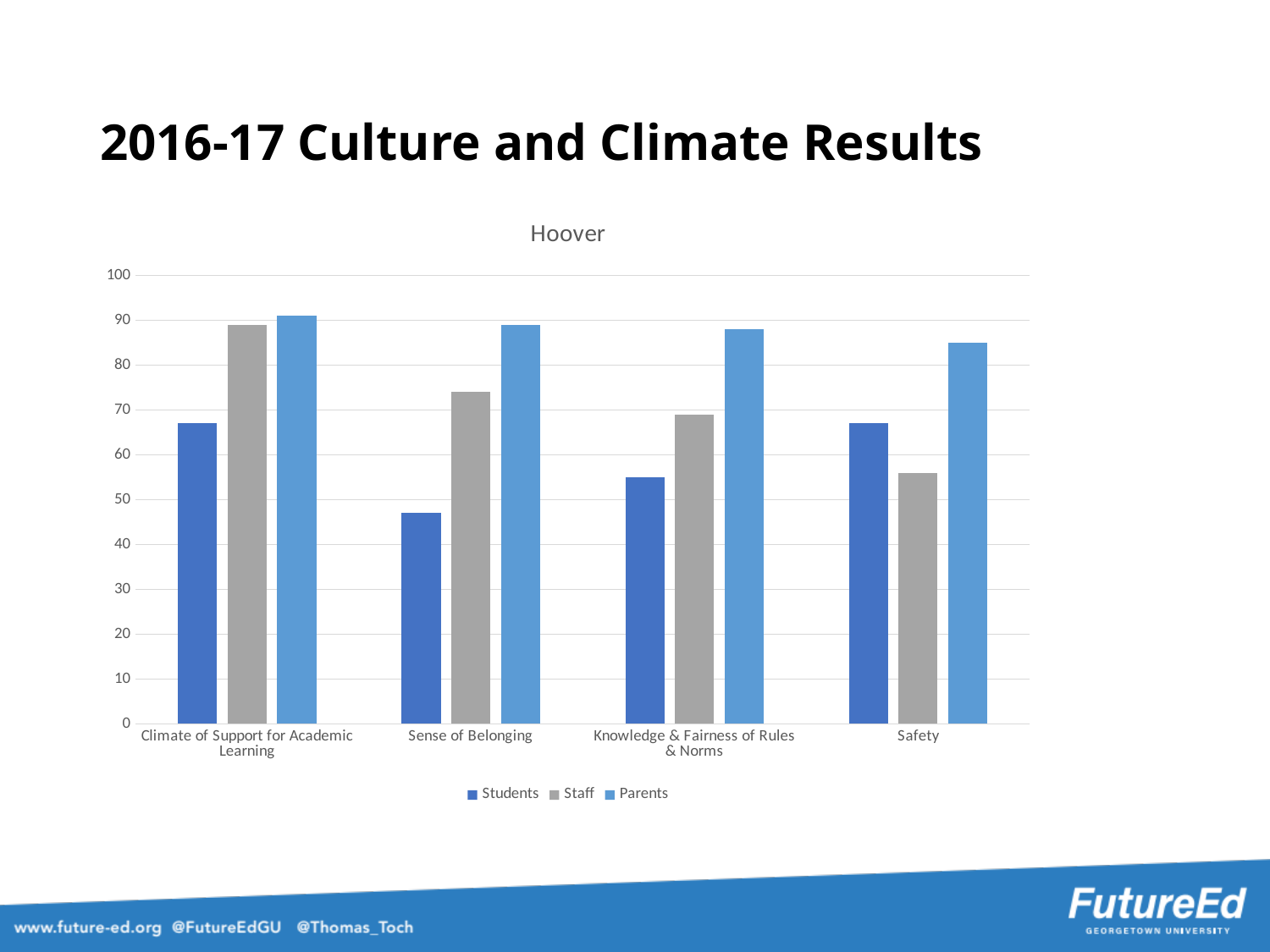
What kind of chart is shown on the slide? bar chart Which series does the legend list first? Students Is the Students value for Sense of Belonging greater or less than 50? less Is the Parents value for Safety greater or less than 80? greater In the Safety category, which is larger, the Students value or the Staff value? Students For which category is the Students value lowest? Sense of Belonging For which category is the Staff value lowest? Safety How many series does the legend list? 3 What is the title of the chart? Hoover Is the Staff value for Climate of Support for Academic Learning greater or less than 80? greater How many categories are shown on the x axis? 4 For which category is the Staff value highest? Climate of Support for Academic Learning